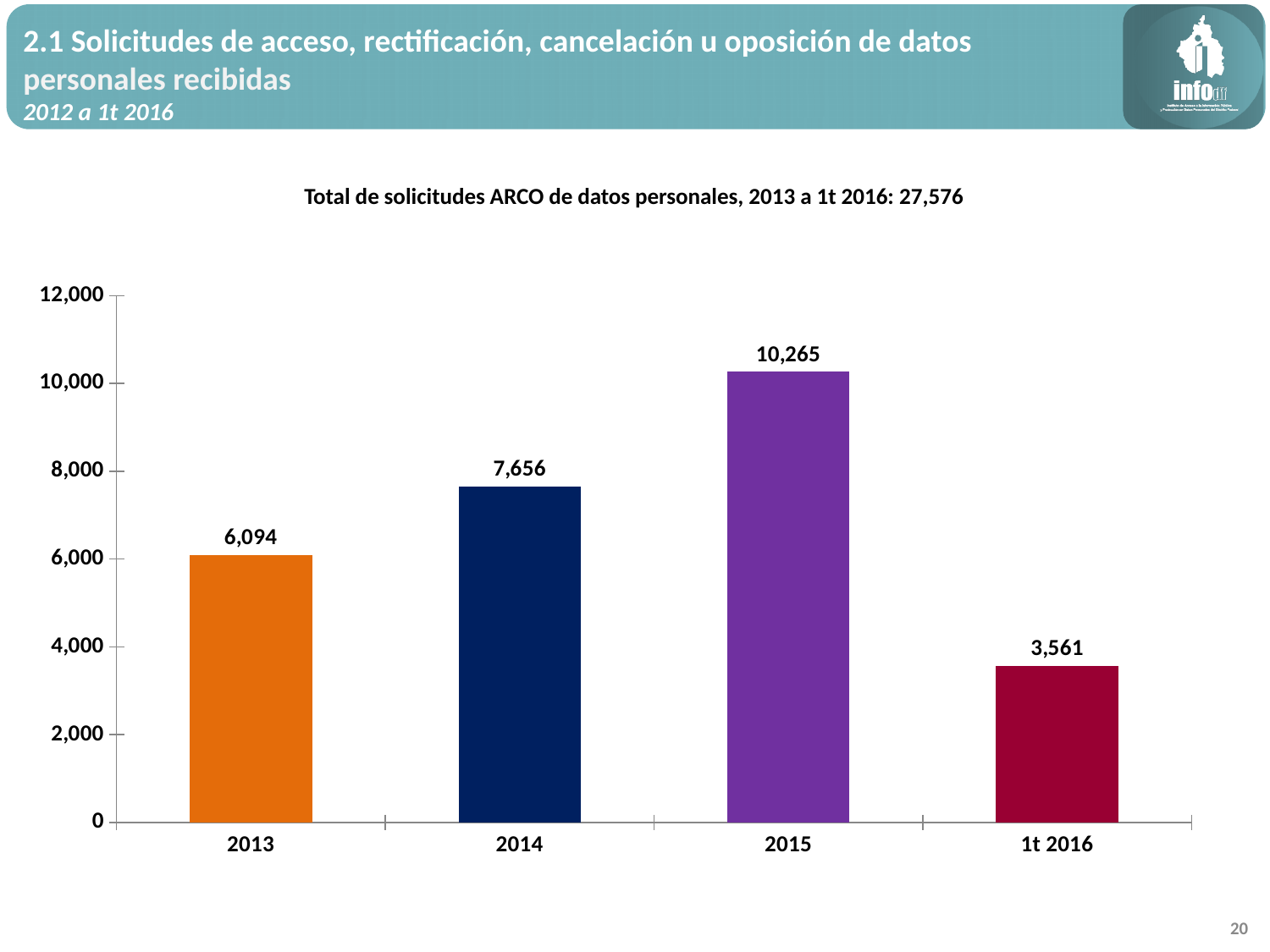
What is the value for 2013? 6,094 Which category has the lowest value? 1t 2016 Is the value for 2015 greater or less than 10,000? greater What total is stated in the text above the chart for solicitudes ARCO de datos personales, 2013 a 1t 2016? 27,576 Which category has the highest value? 2015 What is the value for 1t 2016? 3,561 What kind of chart is shown on the slide? bar chart How many categories are shown on the x axis? 4 What is the value for 2015? 10,265 What is the value for 2014? 7,656 What is the difference between the values for 2015 and 2014? 2,609 Which is larger, the value for 2013 or the value for 2014? 2014